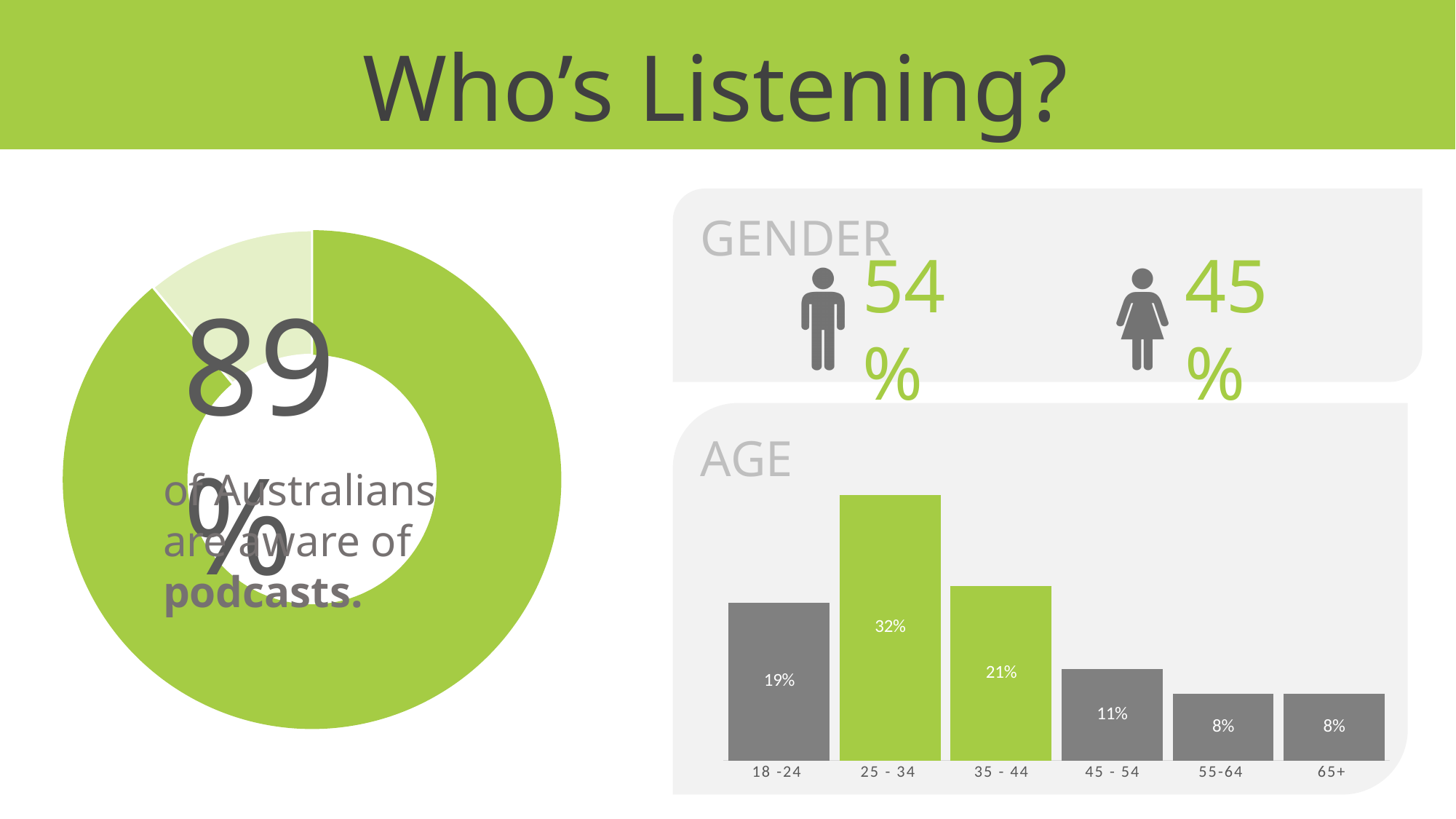
In the AGE bar chart, what value is shown for both the 55-64 and 65+ age groups? 8% In the AGE bar chart, do the values rise or fall from 35 - 44 to 65+? fall In the AGE bar chart, what is the value for the 18 -24 age group? 19% In the AGE bar chart, which is larger, the value for 18 -24 or the value for 35 - 44? 35 - 44 What kind of chart is on the left side of the slide? donut chart In the AGE bar chart, which age group has the highest value? 25 - 34 In the AGE bar chart, what is the value for the 25 - 34 age group? 32% What kind of chart is used in the AGE section? bar chart In the AGE bar chart, what is the value for the 45 - 54 age group? 11% How many age groups are shown in the AGE bar chart? 6 In the AGE bar chart, what is the difference between the 25 - 34 and 35 - 44 values? 11% What percentage of Australians are aware of podcasts, according to the donut chart on the left? 89%